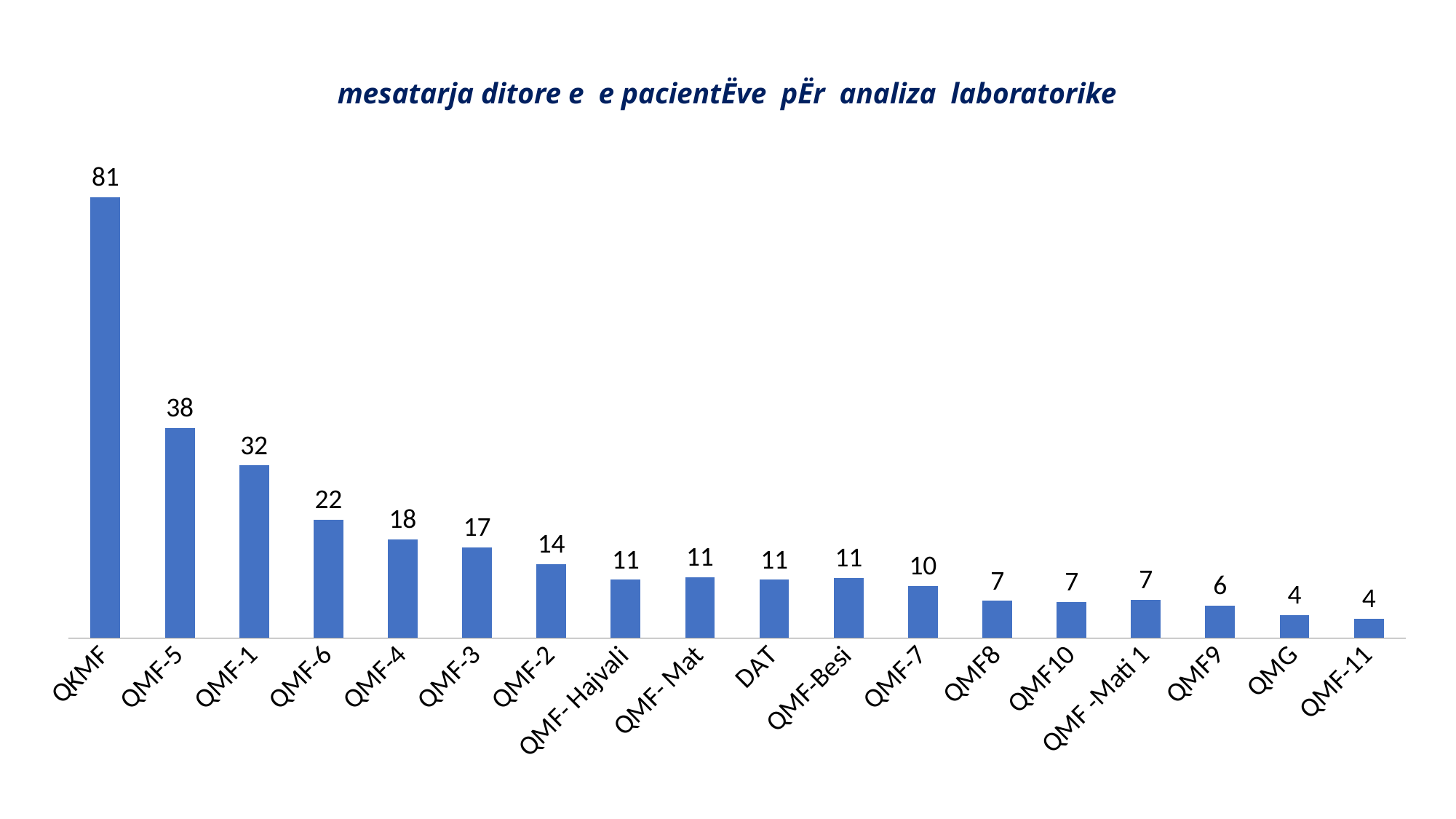
What is the difference between the values for QKMF and QMF-5? 43 Do the values rise or fall from left to right along the x axis? Fall How many categories are shown on the x axis? 18 What is the value for QKMF? 81 What is the difference between the values for QMF-5 and QMF-1? 6 What is the value for QMF-6? 22 What kind of chart is shown on the slide? Bar chart What is the value for QMF9? 6 What is the value for QMF-Besi? 11 Which has a larger value, QMF-7 or QMF8? QMF-7 Which category has the highest value? QKMF Which has a larger value, QMF-4 or QMF-2? QMF-4